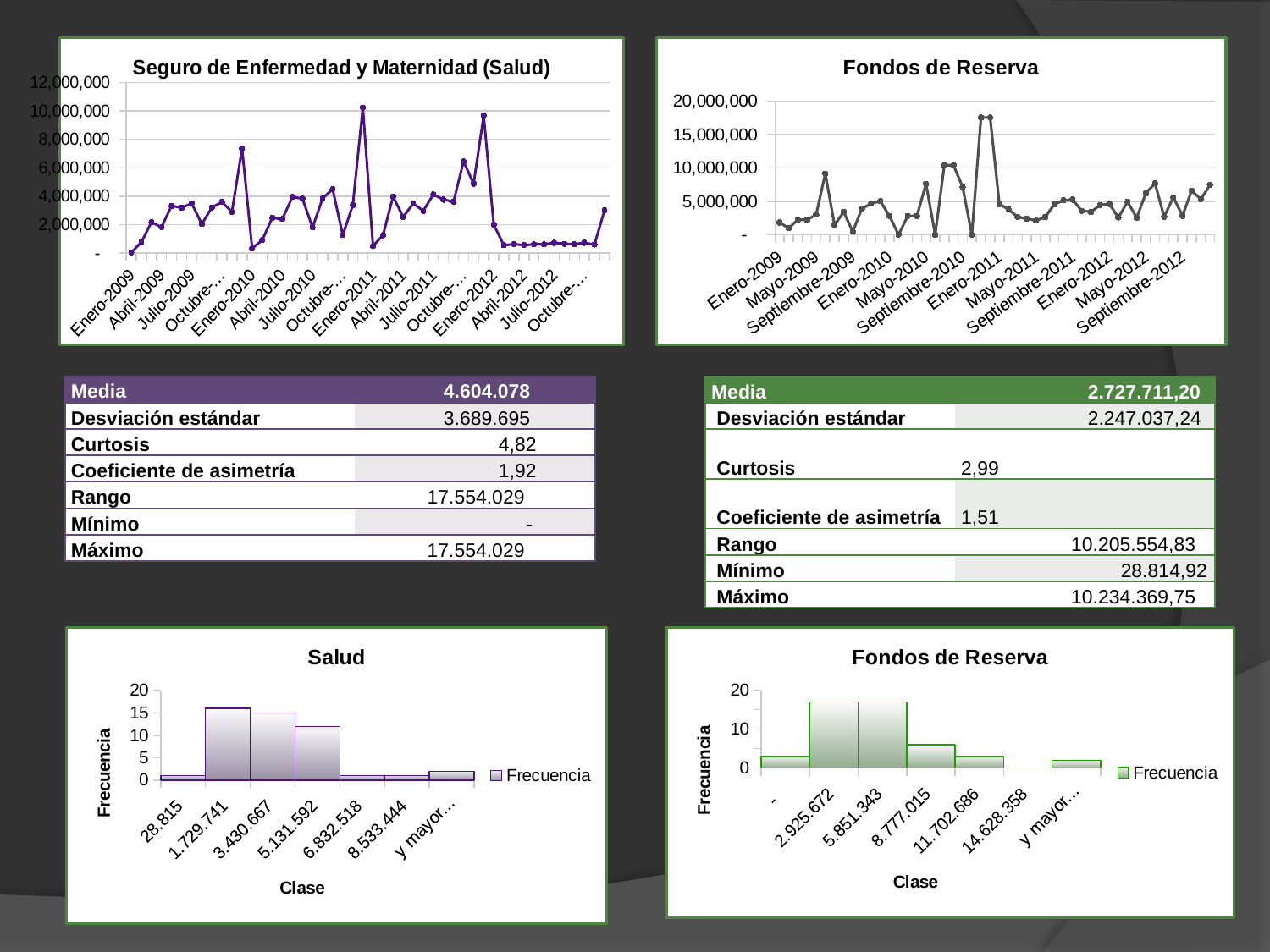
In the bottom-right 'Fondos de Reserva' histogram, is the frequency for class 8.777.015 greater or less than 10? less What is the x-axis title of the bottom-right 'Fondos de Reserva' histogram? Clase What type of chart is the bottom-left chart titled 'Salud'? bar chart What type of chart is the top-left chart titled 'Seguro de Enfermedad y Maternidad (Salud)'? line chart How many series does the legend of the bottom-left 'Salud' histogram list? 1 In the bottom-right 'Fondos de Reserva' histogram, which is larger: the frequency for class 8.777.015 or for class 11.702.686? 8.777.015 In the top-left 'Seguro de Enfermedad y Maternidad (Salud)' chart, is the highest peak greater or less than 8,000,000? greater In the top-right 'Fondos de Reserva' line chart, is the highest peak greater or less than 15,000,000? greater In the bottom-left 'Salud' histogram, which class has the highest frequency? 1.729.741 In the bottom-right 'Fondos de Reserva' histogram, which class has the lowest frequency? 14.628.358 How many classes are shown on the x axis of the bottom-left 'Salud' histogram? 7